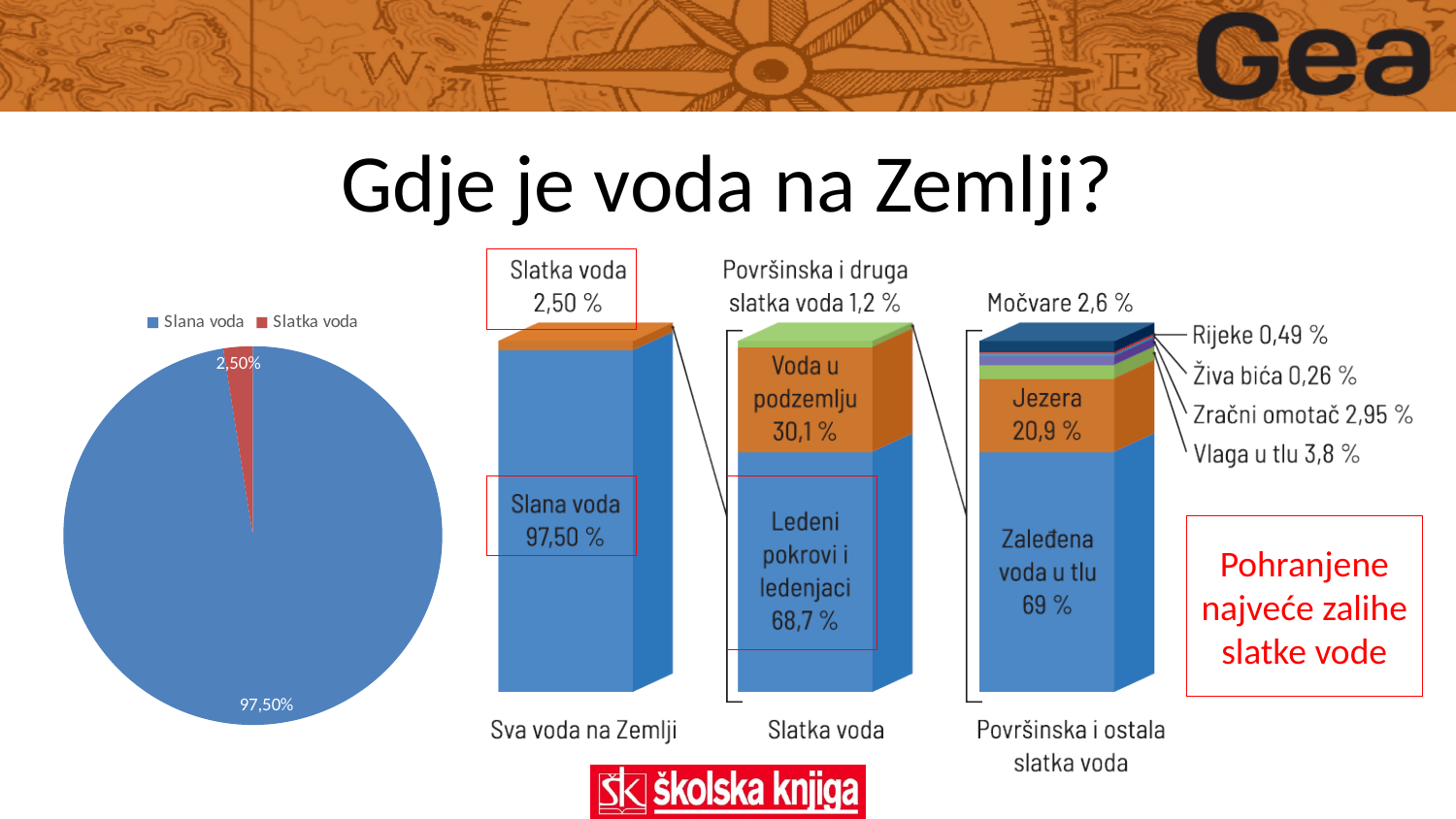
In the stacked bar labelled Površinska i ostala slatka voda on the right, what is the value for Jezera? 20,9 % In the pie chart on the left, which category has the largest slice? Slana voda In the pie chart on the left, which colour represents Slatka voda? red In the stacked bar labelled Površinska i ostala slatka voda on the right, which segment is the largest? Zaleđena voda u tlu In the pie chart on the left, which category has the smallest slice? Slatka voda What kind of chart is shown on the left of the slide? pie chart In the stacked bar labelled Slatka voda in the middle of the slide, what is the value for Voda u podzemlju? 30,1 % In the pie chart on the left, what is the difference between the Slana voda and Slatka voda shares? 95,00% In the pie chart on the left, what is the value for Slana voda? 97,50% In the pie chart on the left, what is the value for Slatka voda? 2,50% In the stacked bar labelled Slatka voda in the middle of the slide, what is the value for Ledeni pokrovi i ledenjaci? 68,7 % In the pie chart on the left, how many categories does the legend list? 2